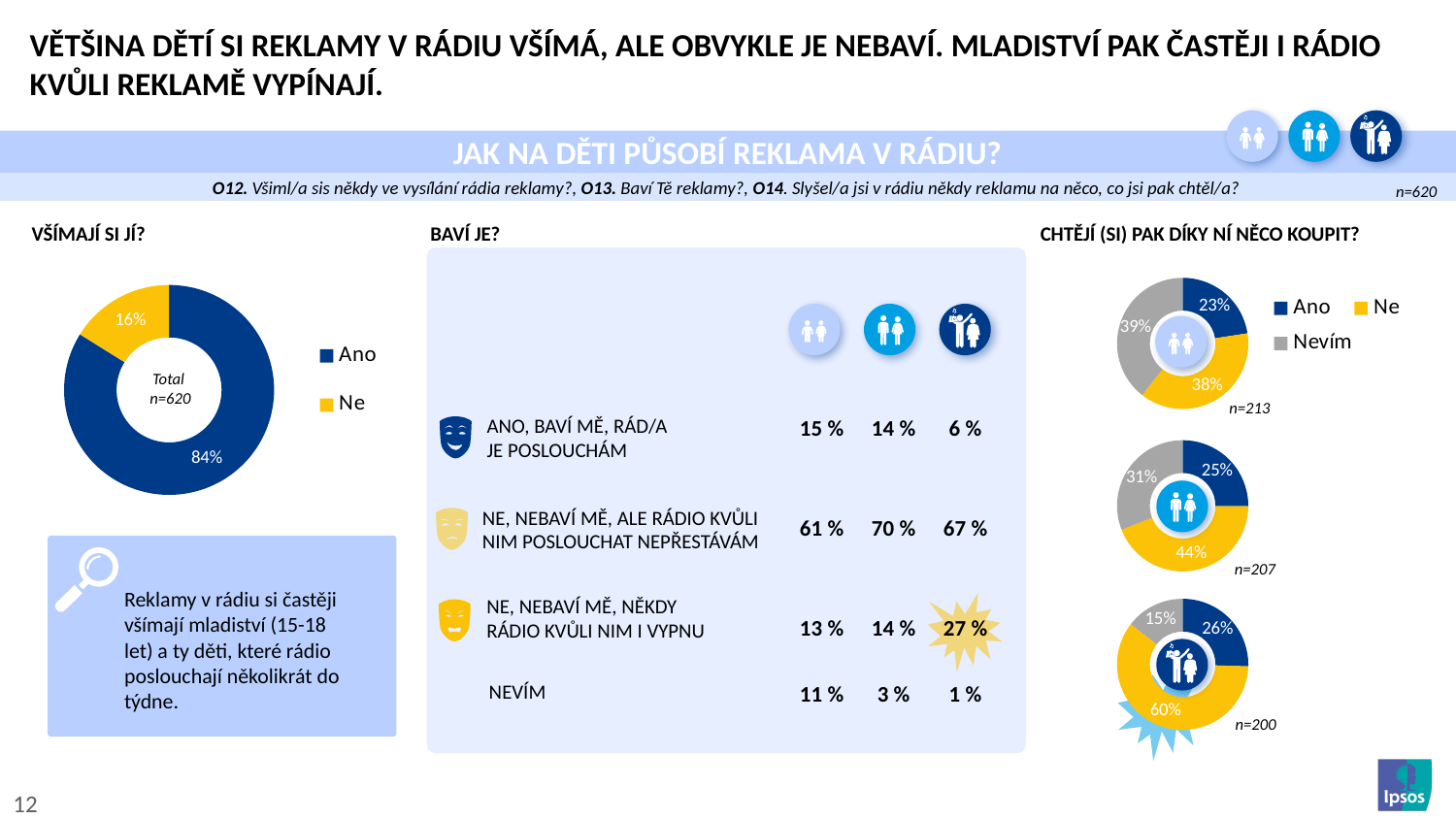
In the 'VŠÍMAJÍ SI JÍ?' chart, what is the difference between the 'Ano' and 'Ne' shares? 68 percentage points What colour represents 'Ne' in the 'CHTĚJÍ (SI) PAK DÍKY NÍ NĚCO KOUPIT?' donut charts? Yellow In the top 'CHTĚJÍ (SI) PAK DÍKY NÍ NĚCO KOUPIT?' donut (n=213), what percentage answered 'Ano'? 23% In the top 'CHTĚJÍ (SI) PAK DÍKY NÍ NĚCO KOUPIT?' donut (n=213), what percentage answered 'Nevím'? 39% In the bottom 'CHTĚJÍ (SI) PAK DÍKY NÍ NĚCO KOUPIT?' donut (n=200), which answer has the largest share? Ne How many series does the legend list for the 'CHTĚJÍ (SI) PAK DÍKY NÍ NĚCO KOUPIT?' charts? 3 In the 'VŠÍMAJÍ SI JÍ?' donut chart, what percentage answered 'Ano'? 84% What type of chart is used under 'VŠÍMAJÍ SI JÍ?'? Donut (pie) chart In the middle 'CHTĚJÍ (SI) PAK DÍKY NÍ NĚCO KOUPIT?' donut (n=207), which is larger: 'Ano' or 'Nevím'? Nevím In the bottom 'CHTĚJÍ (SI) PAK DÍKY NÍ NĚCO KOUPIT?' donut (n=200), what percentage answered 'Nevím'? 15% In the 'VŠÍMAJÍ SI JÍ?' donut chart, what percentage answered 'Ne'? 16% In the middle 'CHTĚJÍ (SI) PAK DÍKY NÍ NĚCO KOUPIT?' donut (n=207), what percentage answered 'Ne'? 44%